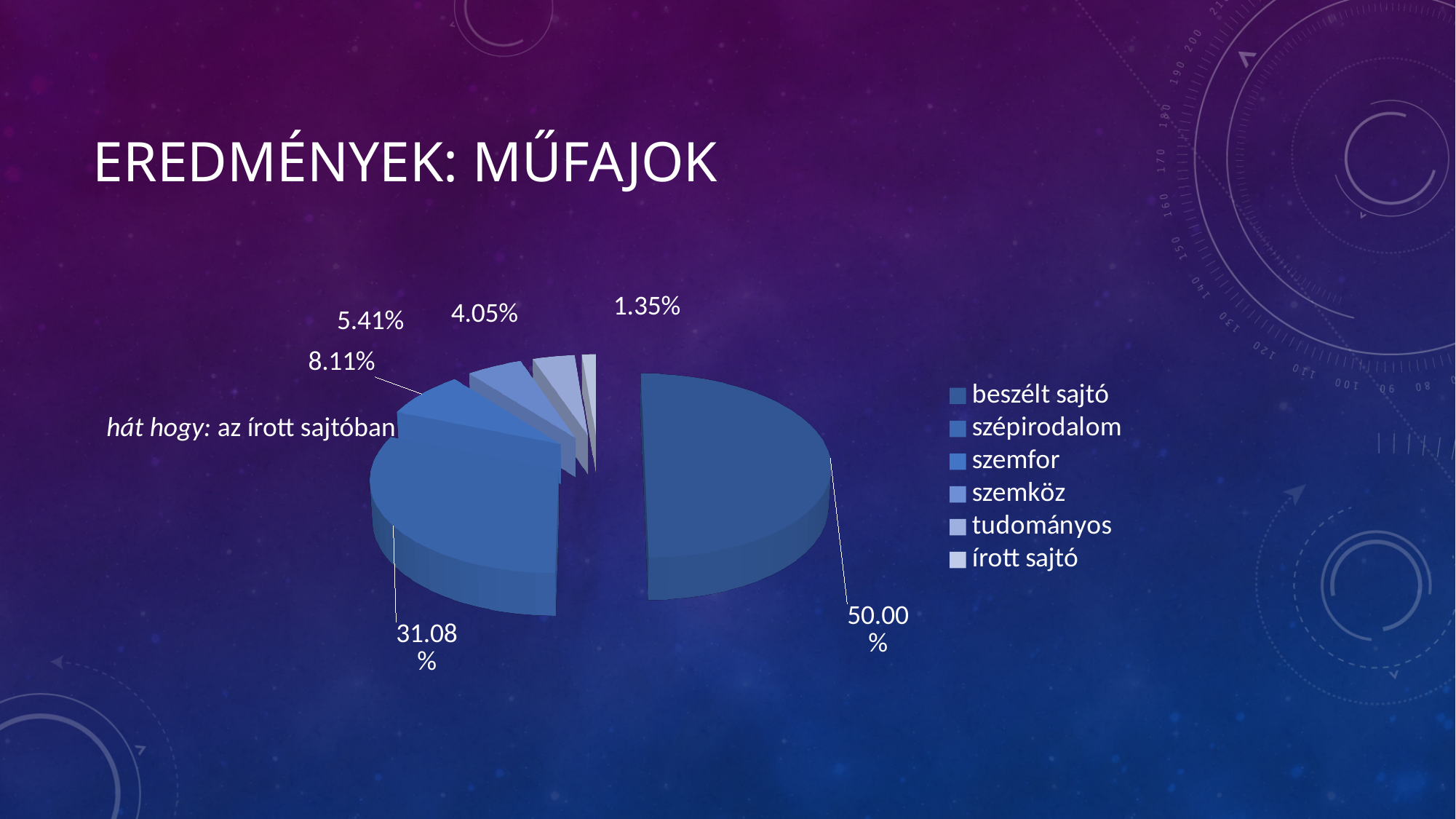
What is the difference between the shares of beszélt sajtó and szépirodalom? 18.92% What percentage is shown for szemfor? 8.11% What share of the pie does beszélt sajtó have? 50.00% Which category has the smallest slice of the pie? írott sajtó Which is larger, the share of szemköz or the share of tudományos? szemköz How many categories does the legend of the pie chart list? 6 What kind of chart is shown on the slide? pie chart What is the title of the slide containing the pie chart? EREDMÉNYEK: MŰFAJOK What percentage is shown for írott sajtó? 1.35% Which category has the largest slice of the pie? beszélt sajtó What share of the pie does szépirodalom have? 31.08% What is the difference between the shares of szemfor and szemköz? 2.70%